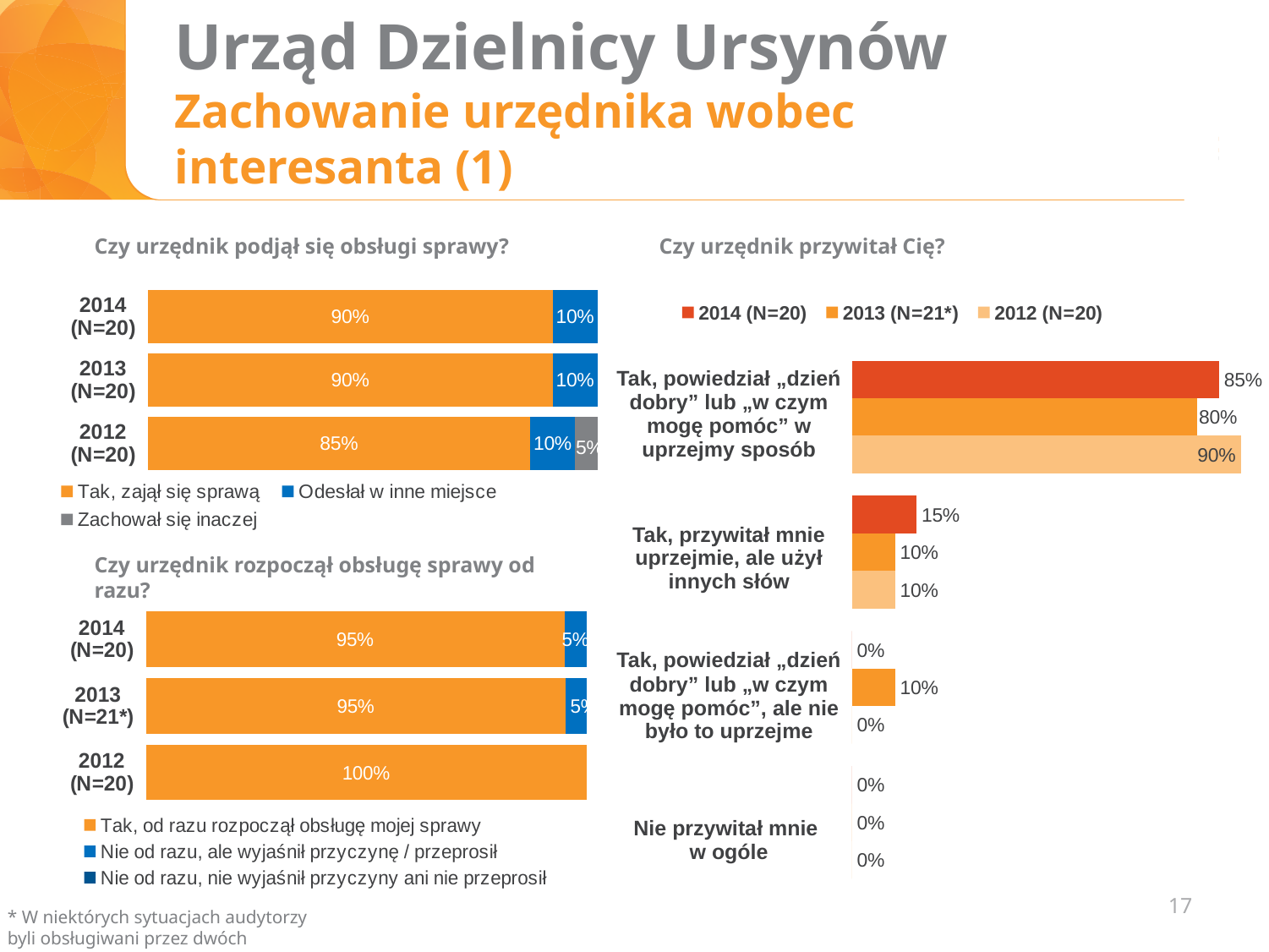
In the chart "Czy urzędnik przywitał Cię?", what is the 2013 (N=21*) value for "Tak, powiedział „dzień dobry” lub „w czym mogę pomóc” w uprzejmy sposób"? 80% In the chart "Czy urzędnik przywitał Cię?", which is larger for "Tak, powiedział „dzień dobry” lub „w czym mogę pomóc” w uprzejmy sposób": 2014 (N=20) or 2012 (N=20)? 2012 (N=20) In the chart "Czy urzędnik przywitał Cię?", what is the 2013 (N=21*) value for "Tak, powiedział „dzień dobry” lub „w czym mogę pomóc”, ale nie było to uprzejme"? 10% In the chart "Czy urzędnik rozpoczął obsługę sprawy od razu?", how many year categories are shown? 3 In the chart "Czy urzędnik podjął się obsługi sprawy?", what percentage for 2014 (N=20) is "Odesłał w inne miejsce"? 10% In the chart "Czy urzędnik podjął się obsługi sprawy?", how many series does the legend list? 3 In the chart "Czy urzędnik podjął się obsługi sprawy?", what is the difference between the "Tak, zajął się sprawą" share in 2014 (N=20) and in 2012 (N=20)? 5 percentage points In the chart "Czy urzędnik przywitał Cię?", which year has the highest value for "Tak, przywitał mnie uprzejmie, ale użył innych słów"? 2014 (N=20) In the chart "Czy urzędnik rozpoczął obsługę sprawy od razu?", which year has the highest share of "Tak, od razu rozpoczął obsługę mojej sprawy"? 2012 (N=20) In the chart "Czy urzędnik podjął się obsługi sprawy?", what percentage for 2012 (N=20) is "Tak, zajął się sprawą"? 85% What kind of chart is "Czy urzędnik przywitał Cię?"? Bar chart In the chart "Czy urzędnik rozpoczął obsługę sprawy od razu?", what percentage for 2012 (N=20) is "Tak, od razu rozpoczął obsługę mojej sprawy"? 100%